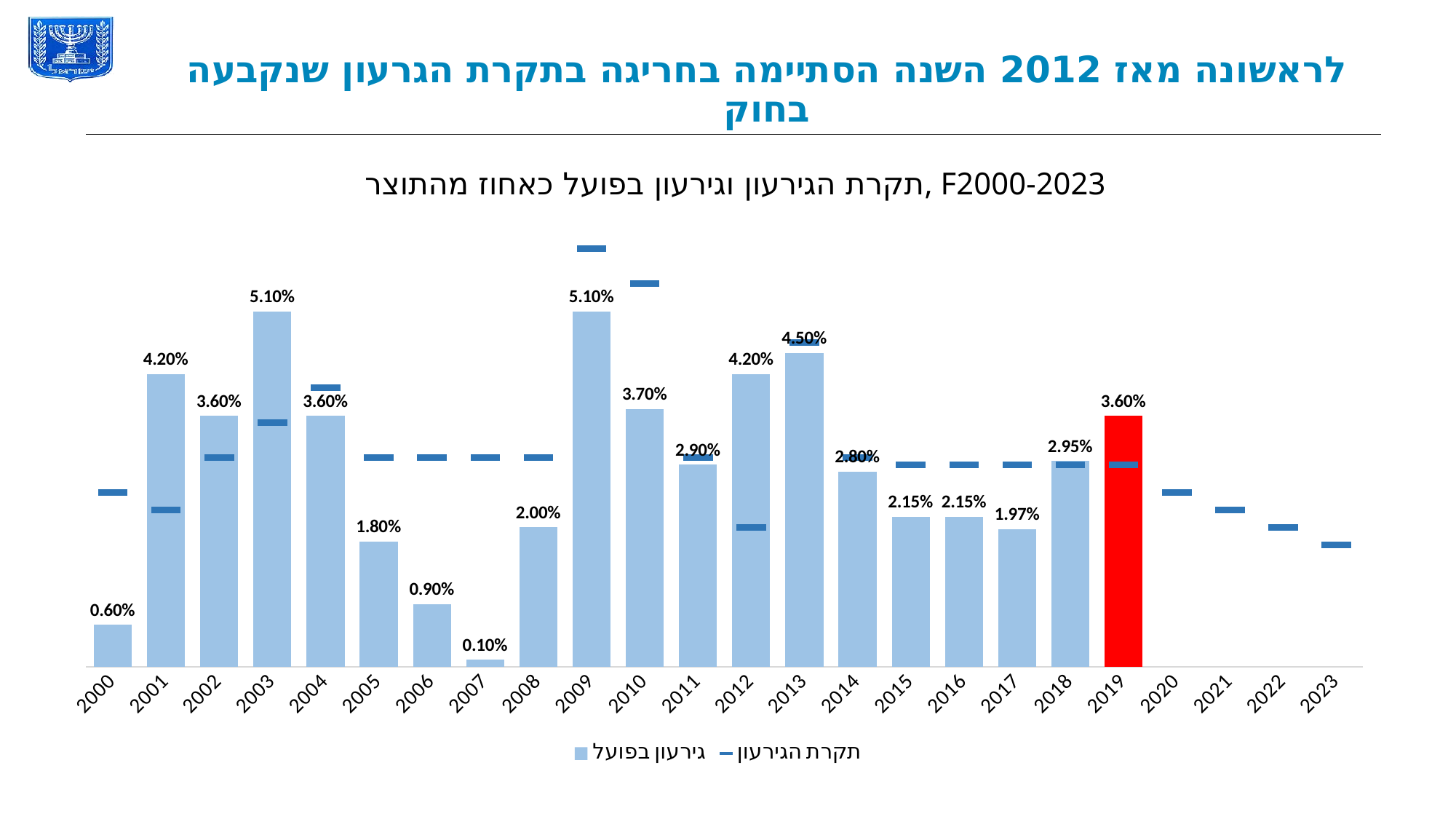
How many series does the legend list? 2 What is the difference between the actual deficit in 2019 and in 2018? 0.65% What kind of chart is shown on the slide? Combination bar and line chart (bars for actual deficit with dash markers for the deficit ceiling) What is the actual deficit (גירעון בפועל) value shown for 2019? 3.60% What is the actual deficit value labelled for 2013? 4.50% What colour is the bar for 2019? Red What is the difference between the actual deficit in 2013 and in 2014? 1.70% Which year has the lowest labelled actual deficit? 2007 How many years are shown on the x axis? 24 Which year has a larger actual deficit, 2001 or 2010? 2001 Which years share the highest labelled actual deficit of 5.10%? 2003 and 2009 What is the actual deficit value labelled for 2007? 0.10%